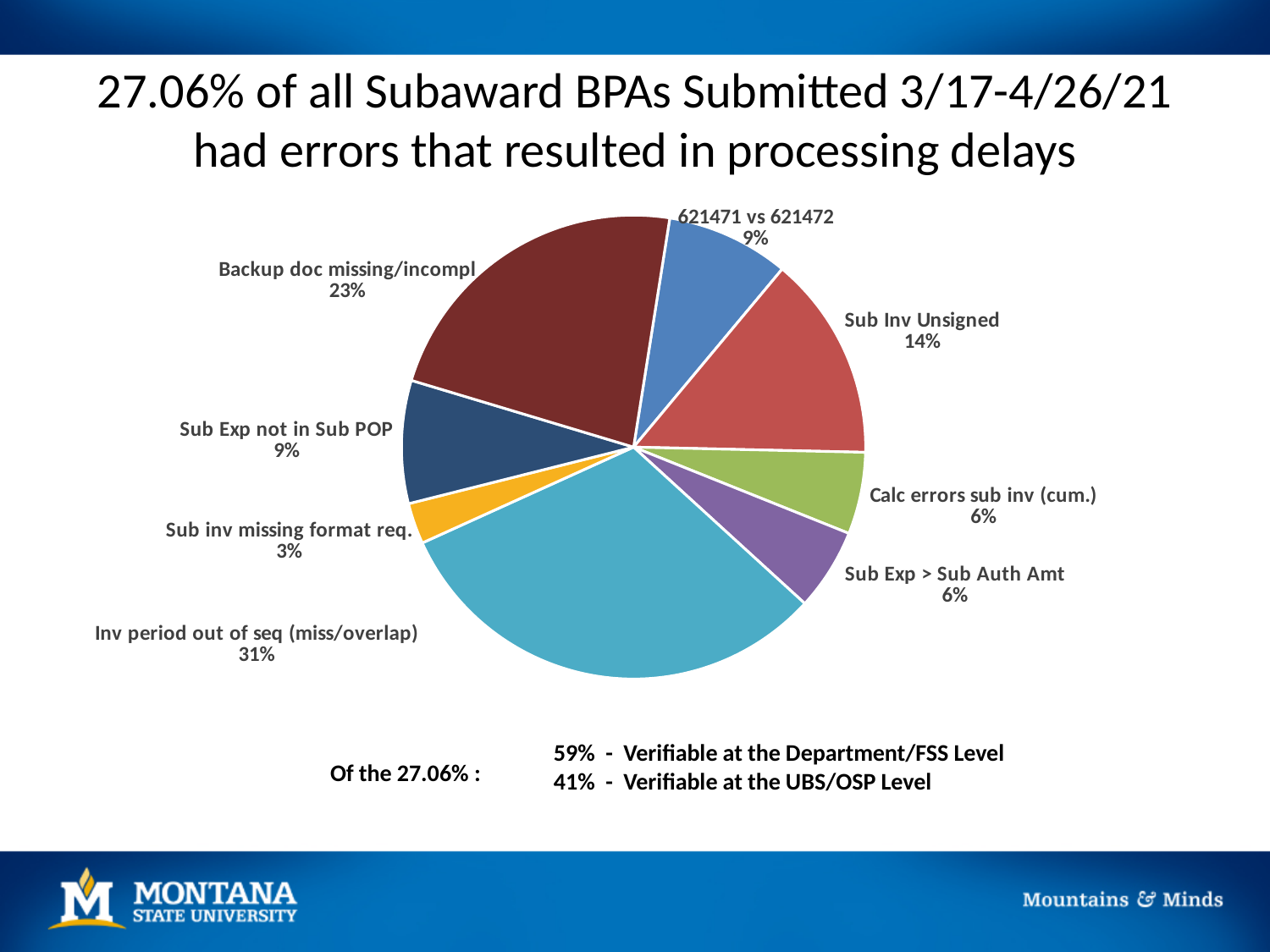
How many slices does the pie chart have? 8 Which is larger, the slice for 'Sub Inv Unsigned' or the slice for 'Sub Exp not in Sub POP'? Sub Inv Unsigned What share of the pie is 'Backup doc missing/incompl'? 23% Which category has the largest slice of the pie? Inv period out of seq (miss/overlap) Which category has the smallest slice of the pie? Sub inv missing format req. What is the combined share of 'Calc errors sub inv (cum.)' and 'Sub Exp > Sub Auth Amt'? 12% What colour is the slice for 'Inv period out of seq (miss/overlap)'? teal/light blue What share of the pie is 'Sub Inv Unsigned'? 14% What kind of chart is shown on the slide? pie chart What share of the pie is 'Inv period out of seq (miss/overlap)'? 31% What is the difference in percentage points between 'Inv period out of seq (miss/overlap)' and 'Backup doc missing/incompl'? 8